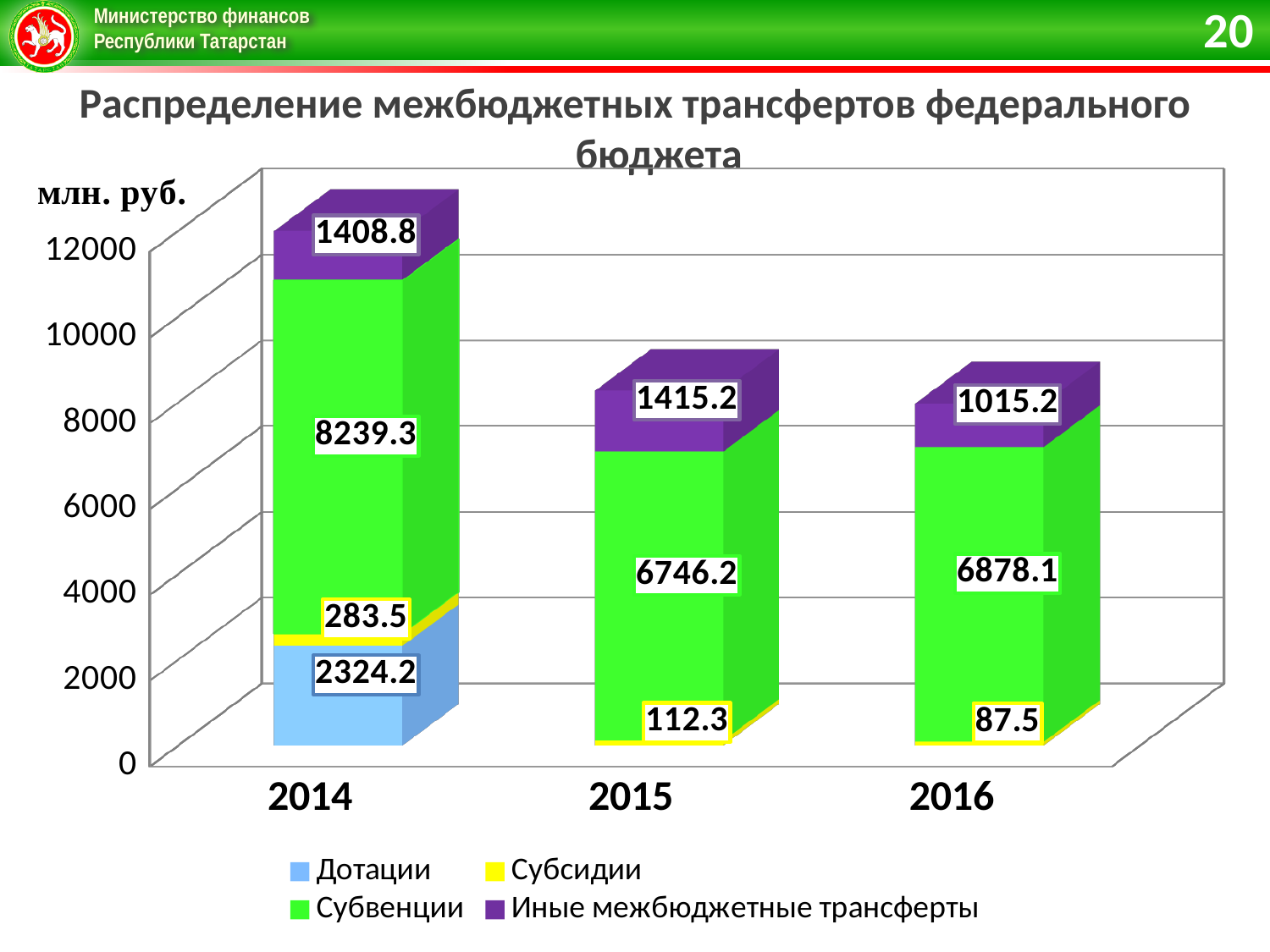
How many series does the legend list? 4 How many years are shown on the x axis? 3 What is the total of the stacked bar for 2014? 12255.8 Which year has the larger value of Иные межбюджетные трансферты, 2014 or 2015? 2015 What is the difference between the Субвенции values for 2016 and 2015? 131.9 What is the value of Иные межбюджетные трансферты for 2015? 1415.2 What is the difference between the Иные межбюджетные трансферты values for 2015 and 2016? 400.0 In which year is the value of Субсидии the lowest? 2016 What is the value of Субсидии for 2016? 87.5 What is the value of Дотации for 2014? 2324.2 In which year is the value of Субвенции the highest? 2014 What is the value of Субвенции for 2014? 8239.3